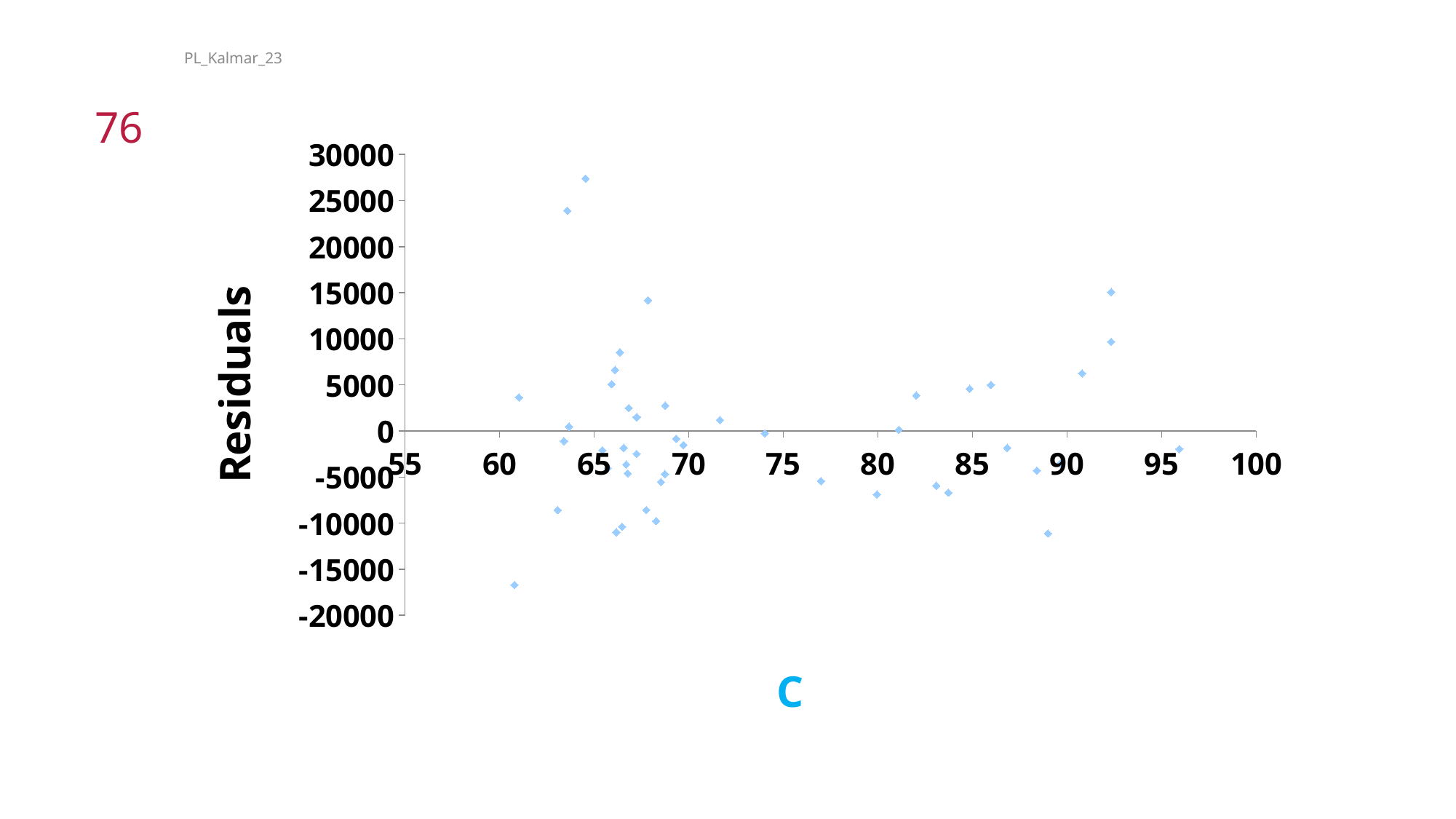
Is the highest residual value plotted on the chart greater or less than 25000? greater What kind of chart is shown on the slide? scatter plot Is the lowest residual value plotted on the chart greater or less than -20000? greater Is the residual for the point with the smallest C value (near C = 61) that lies below the axis greater or less than -15000? less What is the title of the vertical axis of the chart? Residuals What is the title of the horizontal axis of the chart? C